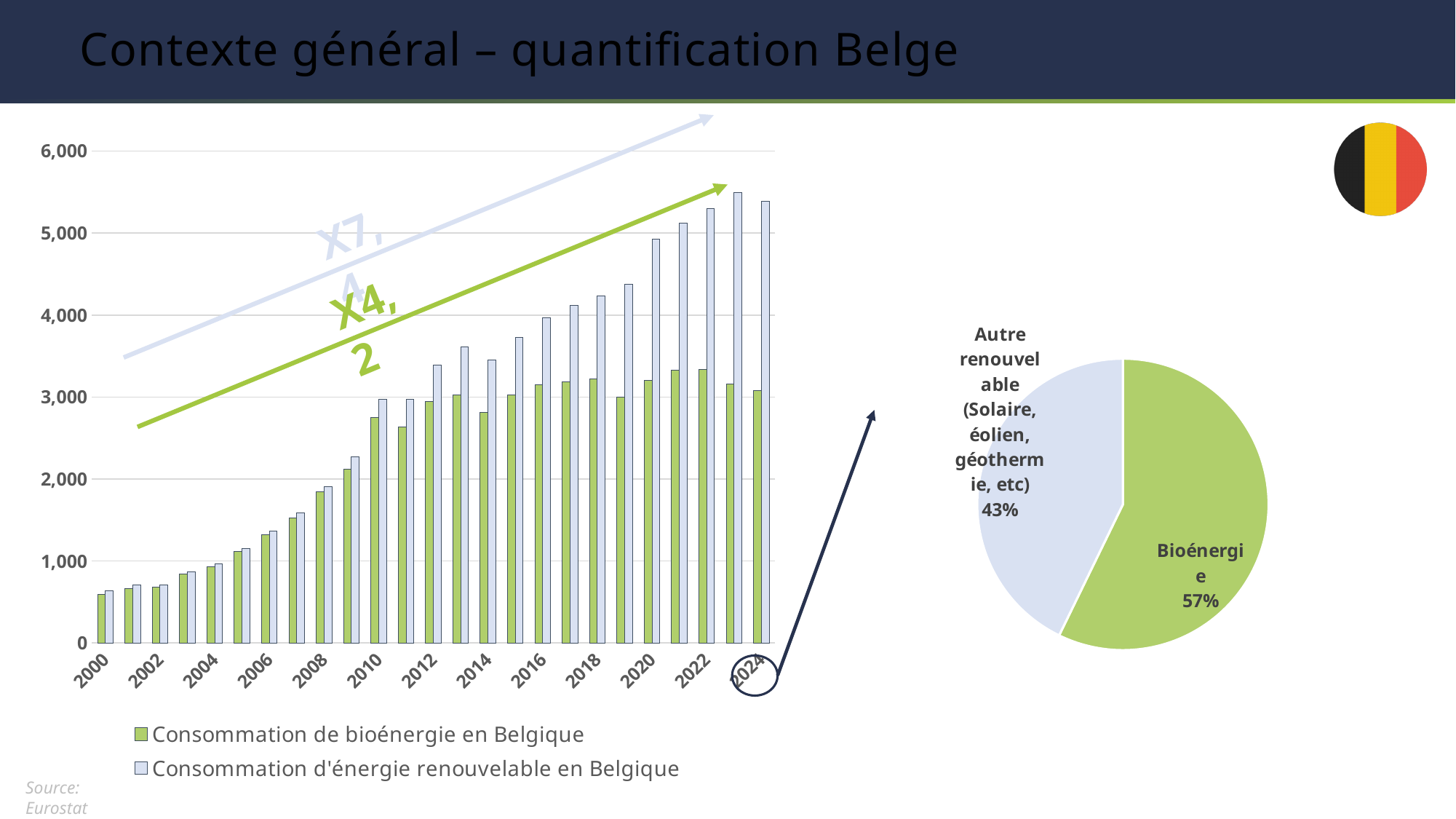
In the bar chart on the left, does 'Consommation d'énergie renouvelable en Belgique' generally rise or fall from 2000 to 2024? rise How many series does the legend of the bar chart on the left list? 2 How many slices does the pie chart on the right have? 2 In the bar chart on the left, which series has the higher value in 2024? Consommation d'énergie renouvelable en Belgique In the bar chart on the left, is the value for 'Consommation d'énergie renouvelable en Belgique' in 2024 greater or less than 5,000? greater In the bar chart on the left, is the value for 'Consommation de bioénergie en Belgique' in 2024 greater or less than 4,000? less In the bar chart on the left, which series is shown in green? Consommation de bioénergie en Belgique In the bar chart on the left, is the value for 'Consommation de bioénergie en Belgique' in 2000 greater or less than 1,000? less In the pie chart on the right, what share does 'Autre renouvelable (Solaire, éolien, géothermie, etc)' have? 43% In the pie chart on the right, which slice is larger, Bioénergie or Autre renouvelable? Bioénergie What kind of chart is the chart on the left of the slide? Bar chart In the pie chart on the right, what share does Bioénergie have? 57%